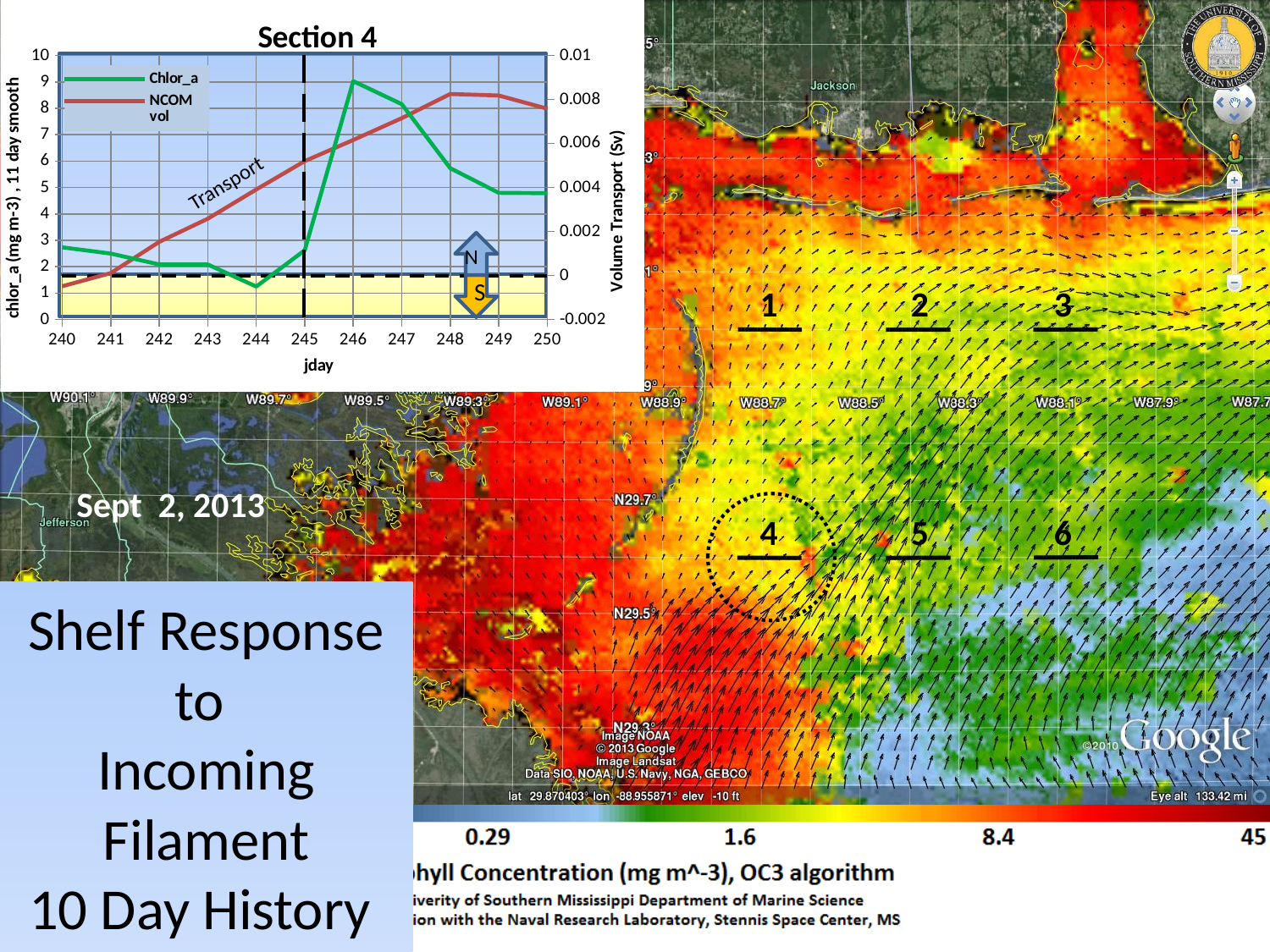
Does the Chlor_a series rise or fall between jday 244 and jday 246? rise At which jday does the Chlor_a series reach its highest value? 246 Is the Chlor_a value at jday 244 greater or less than 2? less At which jday does the Chlor_a series reach its lowest value? 244 How many jday tick marks are labelled on the x axis? 11 What kind of chart is shown on the slide? line chart What label is shown on the x axis of the chart? jday How many series does the chart legend list? 2 What is the title of the chart? Section 4 Is the Chlor_a value at jday 246 greater or less than 8? greater Is the NCOM vol value at jday 245 greater or less than 0.004? greater Which is larger, the Chlor_a value at jday 246 or at jday 248? jday 246